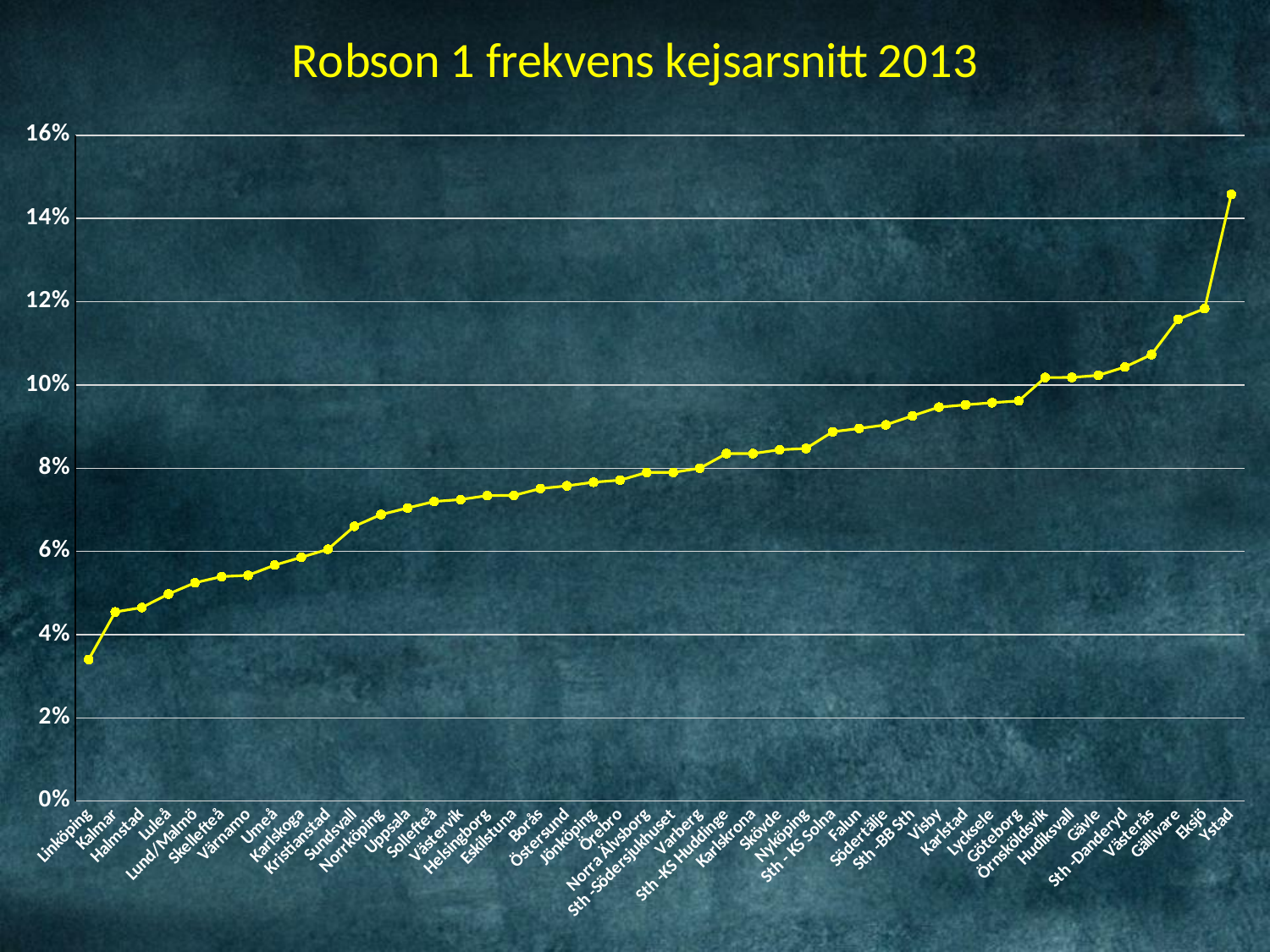
How many categories are plotted on the x axis? 44 Is the value for Göteborg greater or less than 10%? less Is the value for Karlskrona greater or less than 8%? greater Is the value for Linköping greater or less than 4%? less Which category has the highest value? Ystad Which has the larger value, Göteborg or Kalmar? Göteborg Which category has the lowest value? Linköping What is the title of the chart? Robson 1 frekvens kejsarsnitt 2013 Do the values rise or fall from left to right along the x axis? rise What type of chart is shown on the slide? line chart